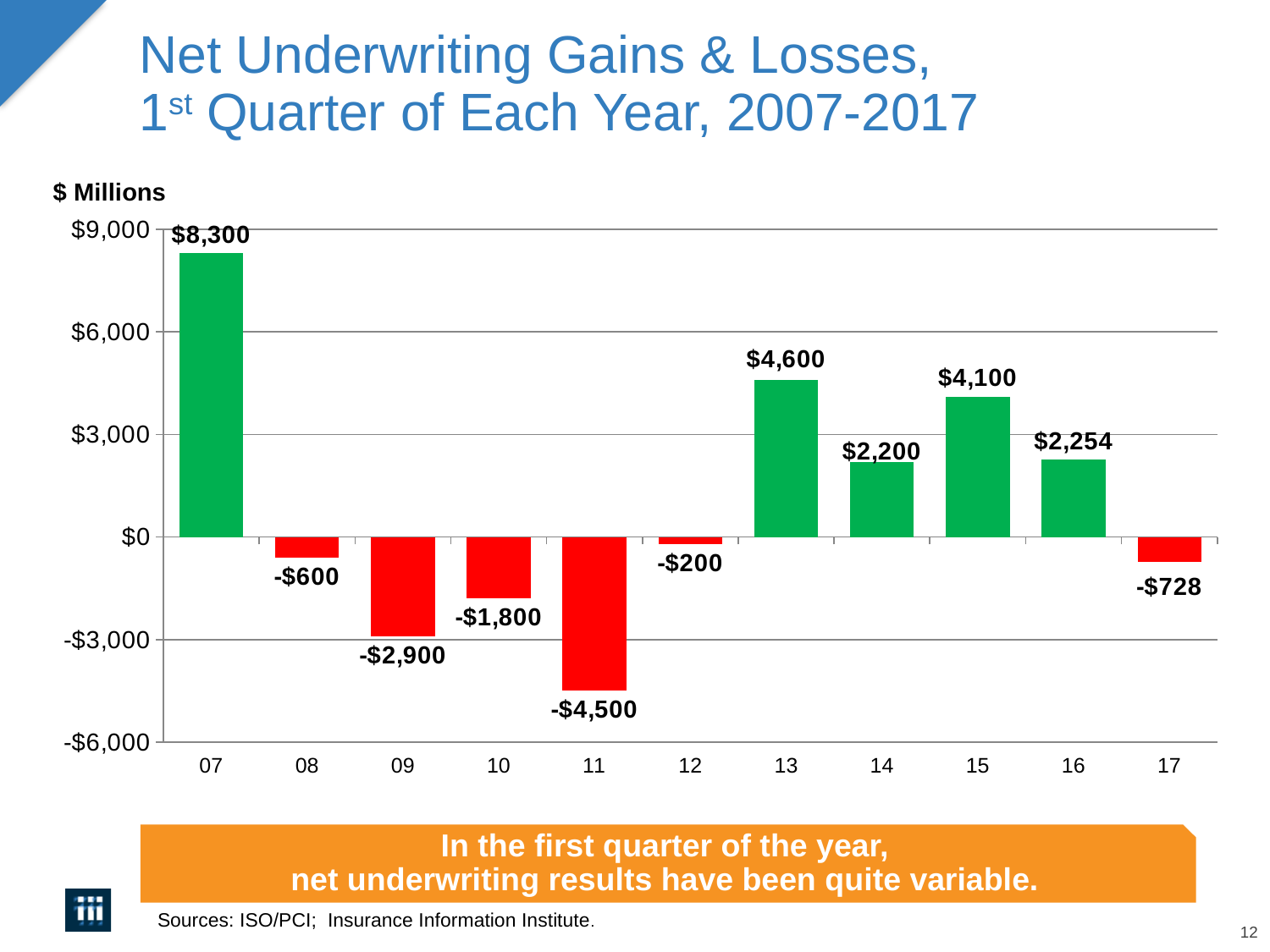
Is the value for 2009 greater or less than -$3,000? greater How many years are shown on the x axis? 11 What is the value shown for 2011? -$4,500 Which is larger, the value for 2014 or the value for 2016? 2016 What unit is stated above the y axis? $ Millions What is the net underwriting gain for the first quarter of 2007? $8,300 What kind of chart is this? bar chart Which year has the lowest value (largest loss)? 11 Which year has the highest net underwriting gain? 07 What is the value shown for 2017? -$728 What is the difference between the values for 2013 and 2015? $500 What is the value shown for 2016? $2,254